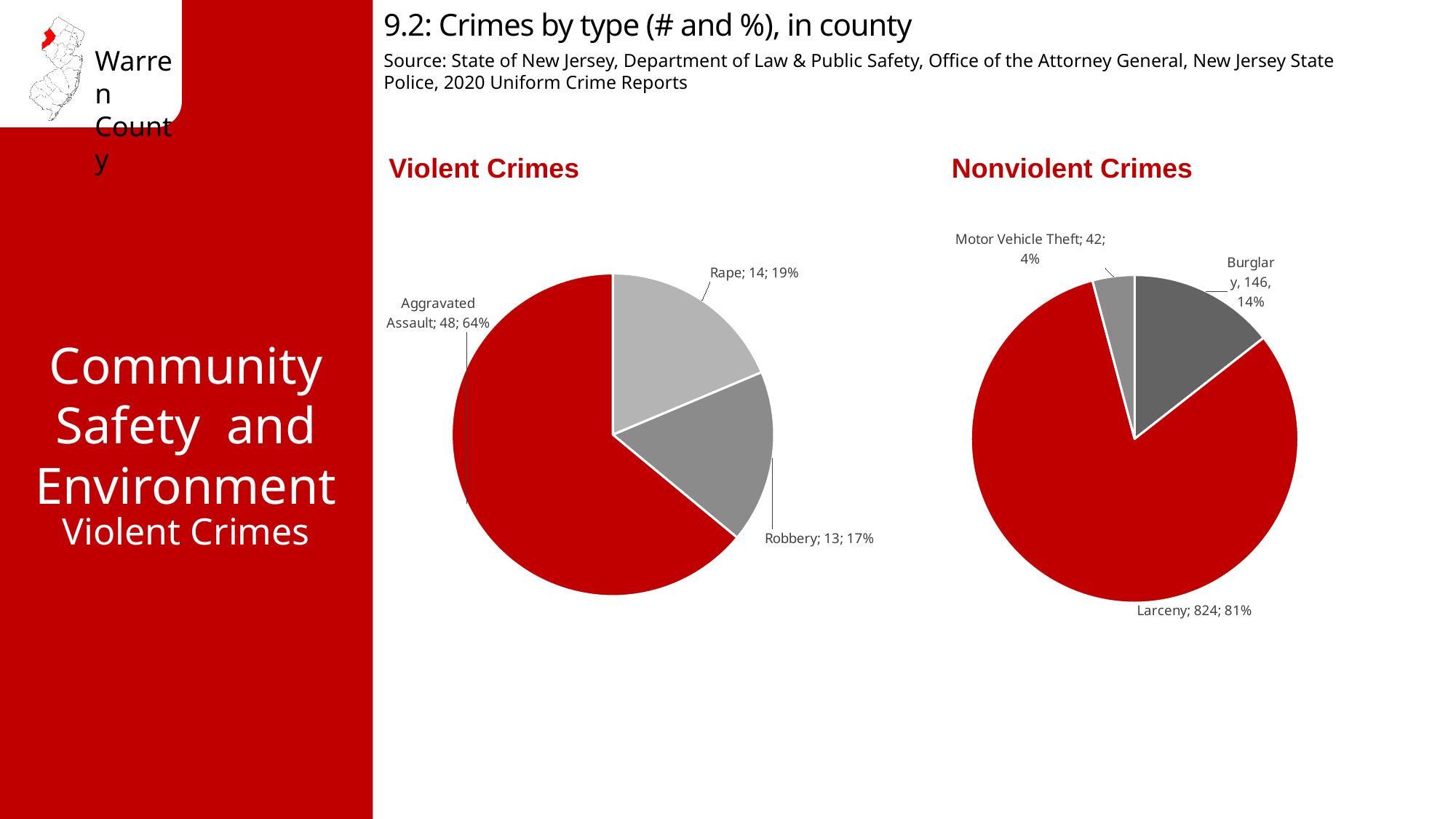
In the Nonviolent Crimes chart, what is the difference between the number of burglaries and motor vehicle thefts? 104 In the Violent Crimes chart, which category has the smallest slice? Robbery In the Violent Crimes chart, what is the difference between the number of aggravated assaults and robberies? 35 In the Nonviolent Crimes chart, how many larcenies are shown? 824 In the Violent Crimes chart, which category has the largest slice? Aggravated Assault In the Nonviolent Crimes chart, which is larger, Burglary or Motor Vehicle Theft? Burglary In the Violent Crimes chart, what percentage share does Rape have? 19% In the Nonviolent Crimes chart, what percentage share does Motor Vehicle Theft have? 4% What type of chart is used for the Violent Crimes chart? Pie chart In the Violent Crimes chart, how many categories are shown? 3 In the Violent Crimes chart, how many aggravated assaults are shown? 48 In the Nonviolent Crimes chart, which category has the smallest slice? Motor Vehicle Theft